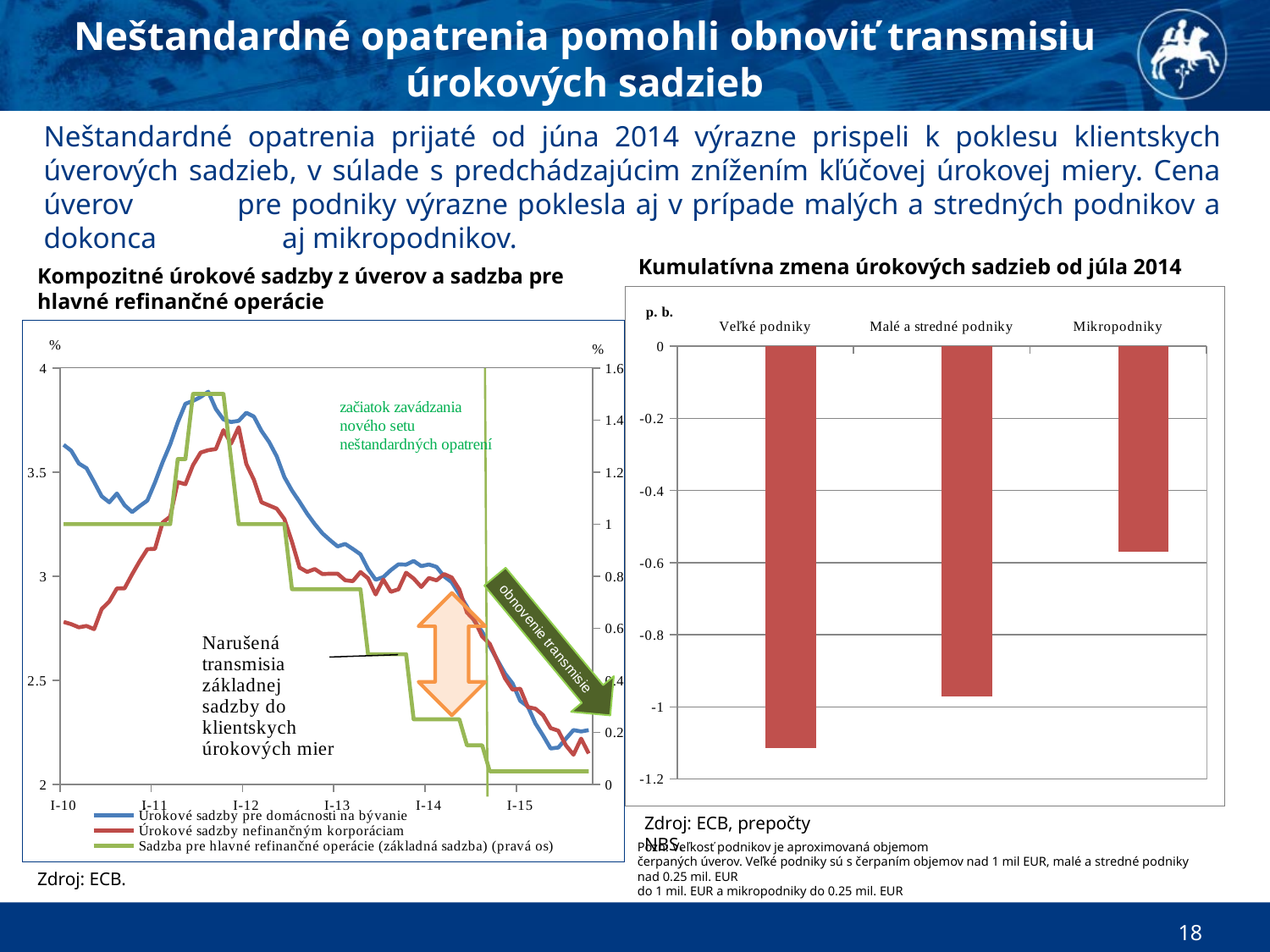
How many categories are shown in the chart 'Kumulatívna zmena úrokových sadzieb od júla 2014'? 3 In the chart 'Kumulatívna zmena úrokových sadzieb od júla 2014', is the value for Mikropodniky greater or less than -0.4? less What kind of chart is the chart titled 'Kompozitné úrokové sadzby z úverov a sadzba pre hlavné refinančné operácie'? line chart In the chart 'Kumulatívna zmena úrokových sadzieb od júla 2014', which has the larger decline: Veľké podniky or Mikropodniky? Veľké podniky In the chart 'Kumulatívna zmena úrokových sadzieb od júla 2014', is the value for Malé a stredné podniky greater or less than -1? greater In the chart 'Kompozitné úrokové sadzby z úverov a sadzba pre hlavné refinančné operácie', do the 'Úrokové sadzby pre domácnosti na bývanie' rise or fall between I-14 and I-15? fall In the chart 'Kumulatívna zmena úrokových sadzieb od júla 2014', which category shows the largest decline (lowest value)? Veľké podniky How many series does the legend of the chart 'Kompozitné úrokové sadzby z úverov a sadzba pre hlavné refinančné operácie' list? 3 In the chart 'Kumulatívna zmena úrokových sadzieb od júla 2014', is the value for Veľké podniky greater or less than -1? less What kind of chart is the chart titled 'Kumulatívna zmena úrokových sadzieb od júla 2014'? bar chart In the chart 'Kumulatívna zmena úrokových sadzieb od júla 2014', which category shows the smallest decline (value closest to zero)? Mikropodniky What unit is shown on the vertical axis of the chart 'Kumulatívna zmena úrokových sadzieb od júla 2014'? p. b.